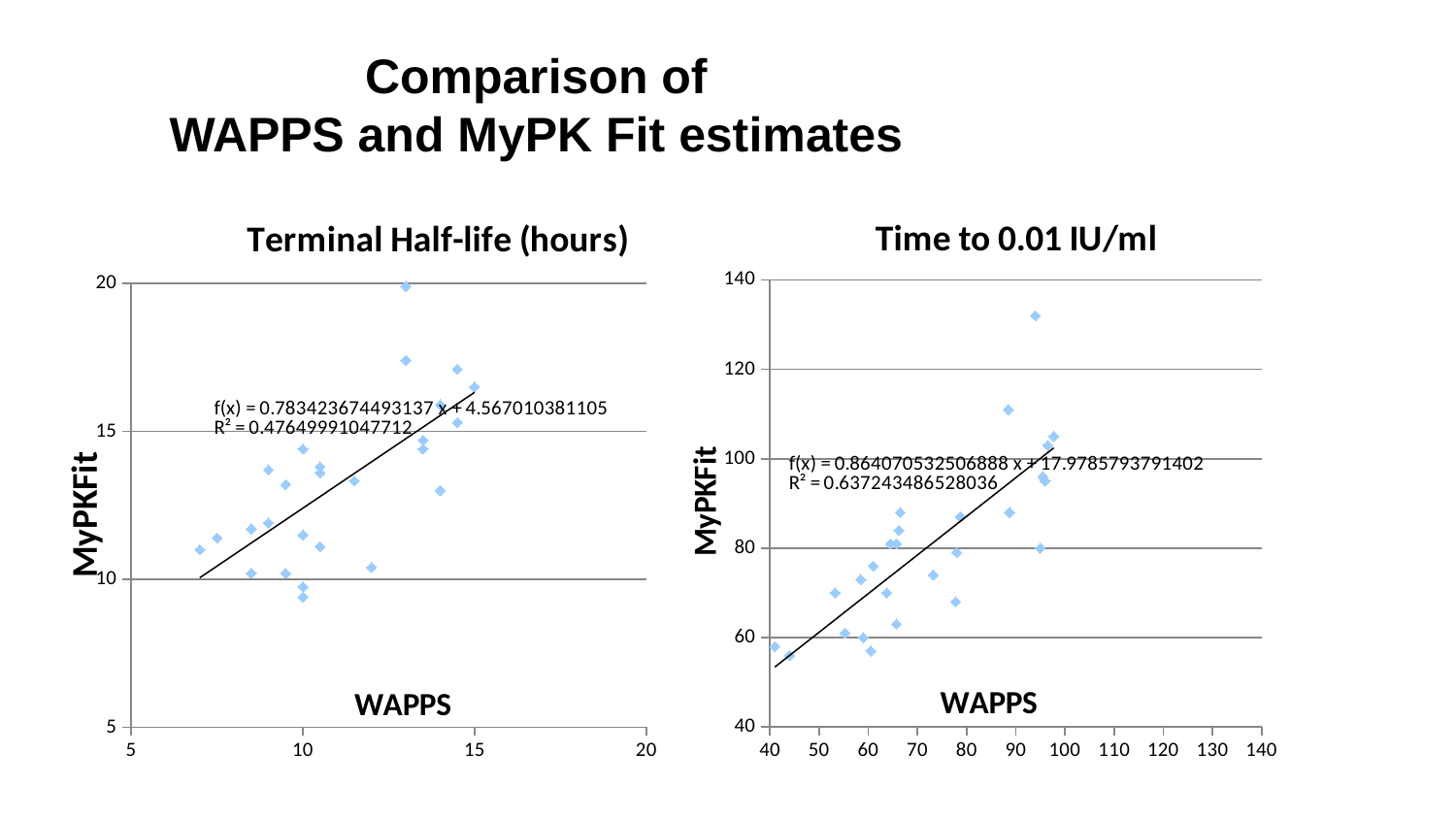
In the 'Time to 0.01 IU/ml' chart, do the MyPKFit values generally rise or fall as WAPPS increases? rise What kind of chart is the 'Terminal Half-life (hours)' chart? scatter chart What is the y-axis label on the 'Terminal Half-life (hours)' chart? MyPKFit Which chart has the higher R² value, 'Terminal Half-life (hours)' or 'Time to 0.01 IU/ml'? Time to 0.01 IU/ml In the 'Terminal Half-life (hours)' chart, do the MyPKFit values generally rise or fall as WAPPS increases? rise In the 'Time to 0.01 IU/ml' chart, what is the R² value shown for the trendline? 0.637243486528036 In the 'Time to 0.01 IU/ml' chart, is the MyPKFit value of the highest point greater or less than 120? greater In the 'Terminal Half-life (hours)' chart, is the MyPKFit value of the lowest point greater or less than 10? less In the 'Terminal Half-life (hours)' chart, what is the R² value shown for the trendline? 0.47649991047712 In the 'Time to 0.01 IU/ml' chart, is the MyPKFit value of the lowest point greater or less than 60? less What is the x-axis label on the 'Time to 0.01 IU/ml' chart? WAPPS What kind of chart is the 'Time to 0.01 IU/ml' chart? scatter chart